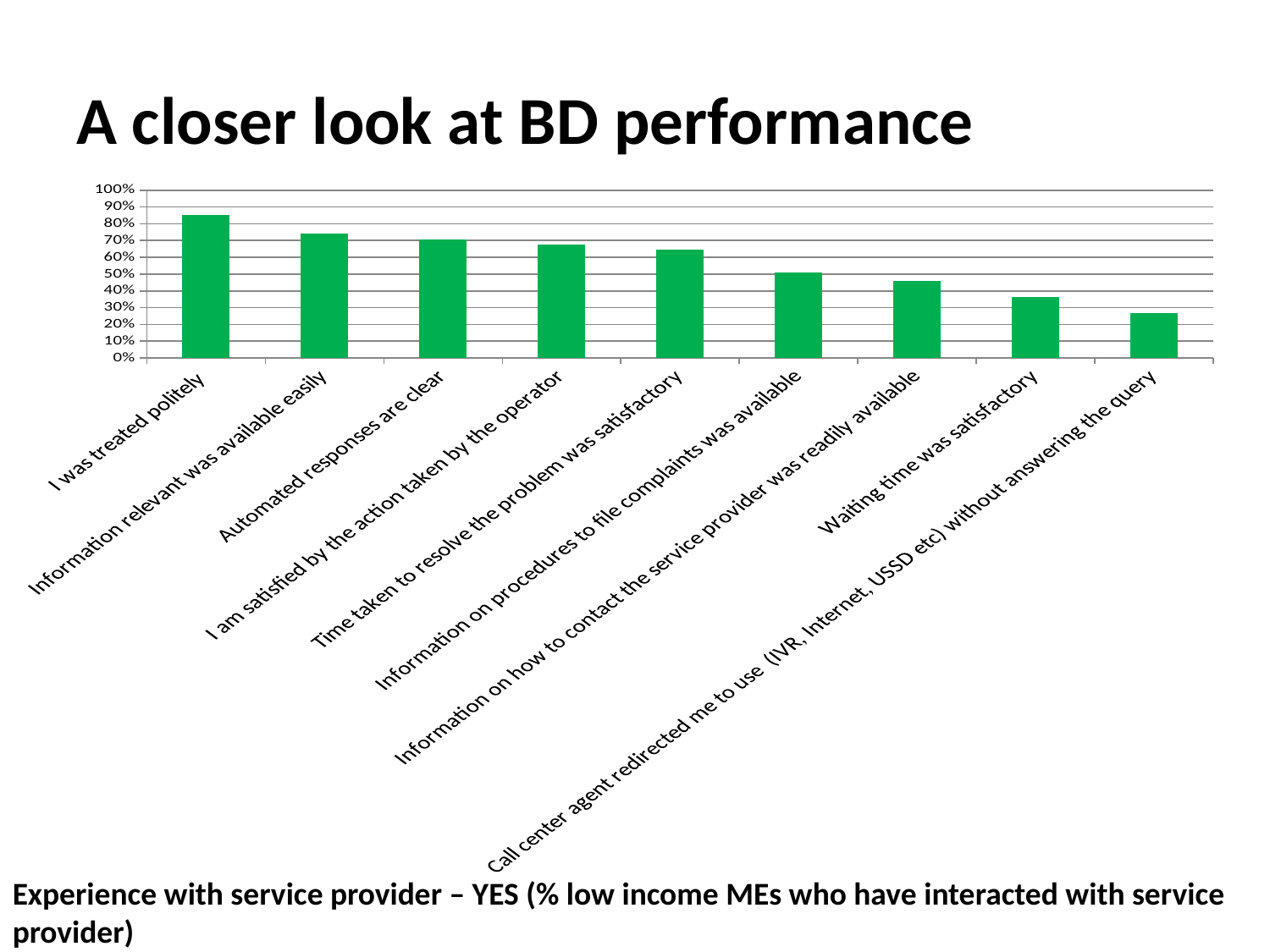
What kind of chart is shown on the slide? bar chart Is the value for "Information on how to contact the service provider was readily available" greater or less than 50%? less Is the value for "I was treated politely" greater or less than 80%? greater What colour are the bars in the chart? green Is the value for "Call center agent redirected me to use (IVR, Internet, USSD etc) without answering the query" greater or less than 30%? less How many categories are plotted in the chart? 9 Which is larger: the value for "Information relevant was available easily" or the value for "Waiting time was satisfactory"? Information relevant was available easily Which category has the highest value in the chart? I was treated politely Do the bar values rise or fall from left to right across the chart? fall Which category has the lowest value in the chart? Call center agent redirected me to use (IVR, Internet, USSD etc) without answering the query